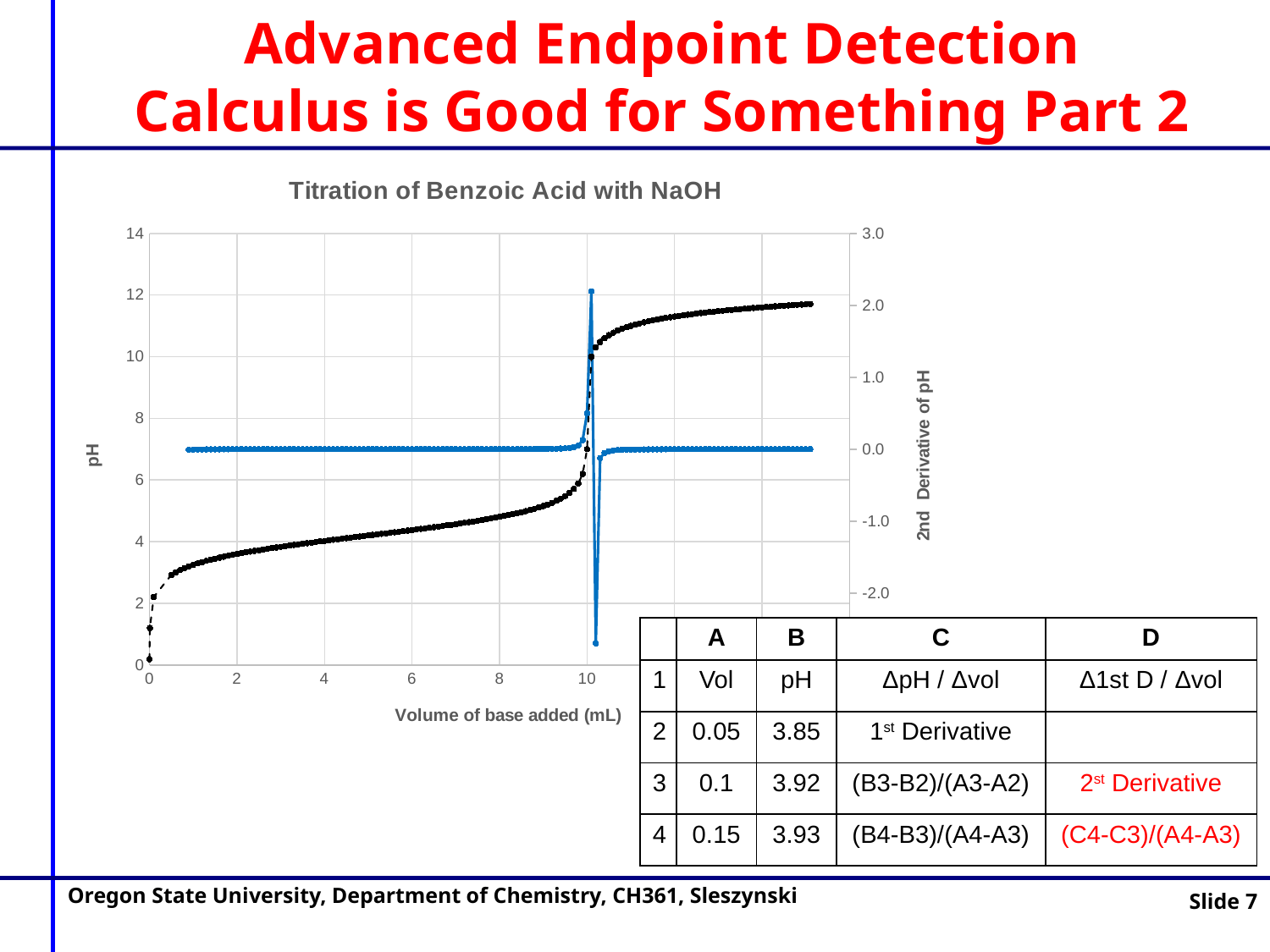
Is the pH at 11 mL of base added greater or less than 10? greater What is the maximum value shown on the left pH axis? 14 Does the pH (black curve) rise or fall as the volume of base added increases? rise What is the label of the x axis of the chart? Volume of base added (mL) Is the pH at 6 mL of base added greater or less than 6? less Is the pH at 8 mL of base added greater or less than 6? less How many data series are plotted on the chart? 2 What is the title of the chart? Titration of Benzoic Acid with NaOH What kind of chart is shown on the slide? line chart